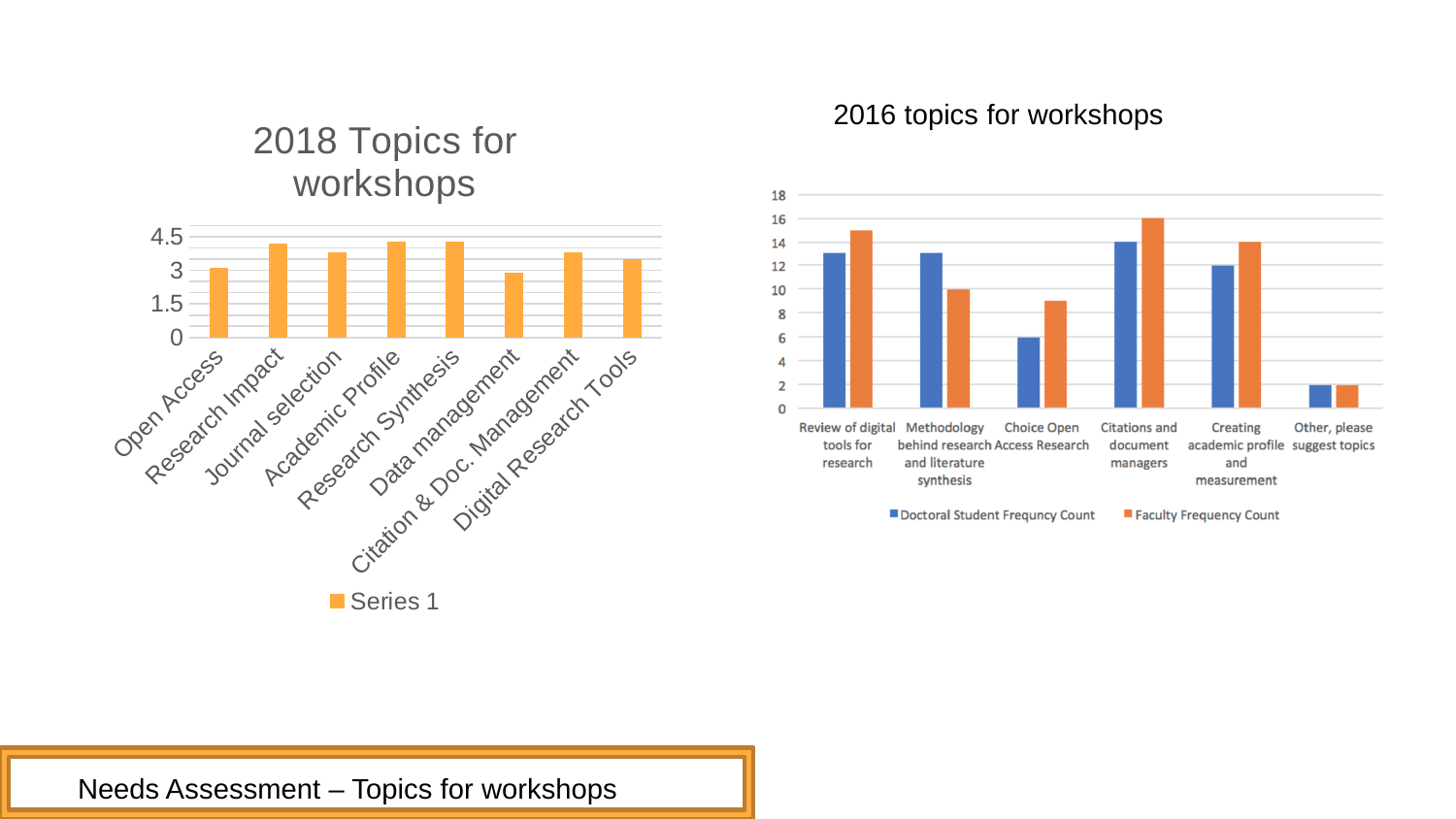
What kind of chart is the 2018 Topics for workshops chart? Bar chart On the 2016 topics for workshops chart, what is the Faculty Frequency Count for Citations and document managers? 16 On the 2016 topics for workshops chart, what is the Doctoral Student Frequency Count for Choice Open Access Research? 6 On the 2016 topics for workshops chart, which topic has the lowest Doctoral Student Frequency Count? Other, please suggest topics How many series does the legend of the 2016 topics for workshops chart list? 2 On the 2016 topics for workshops chart, what is the Faculty Frequency Count for Methodology behind research and literature synthesis? 10 On the 2016 topics for workshops chart, which is larger for Creating academic profile and measurement: the Doctoral Student count or the Faculty count? Faculty Frequency Count On the 2016 topics for workshops chart, which topic has the highest Faculty Frequency Count? Citations and document managers How many topics are shown on the 2016 topics for workshops chart? 6 On the 2018 Topics for workshops chart, is the value for Research Impact greater or less than 3? greater On the 2016 topics for workshops chart, what is the difference between the Faculty and Doctoral Student counts for Citations and document managers? 2 On the 2018 Topics for workshops chart, which topic has the lowest value? Data management